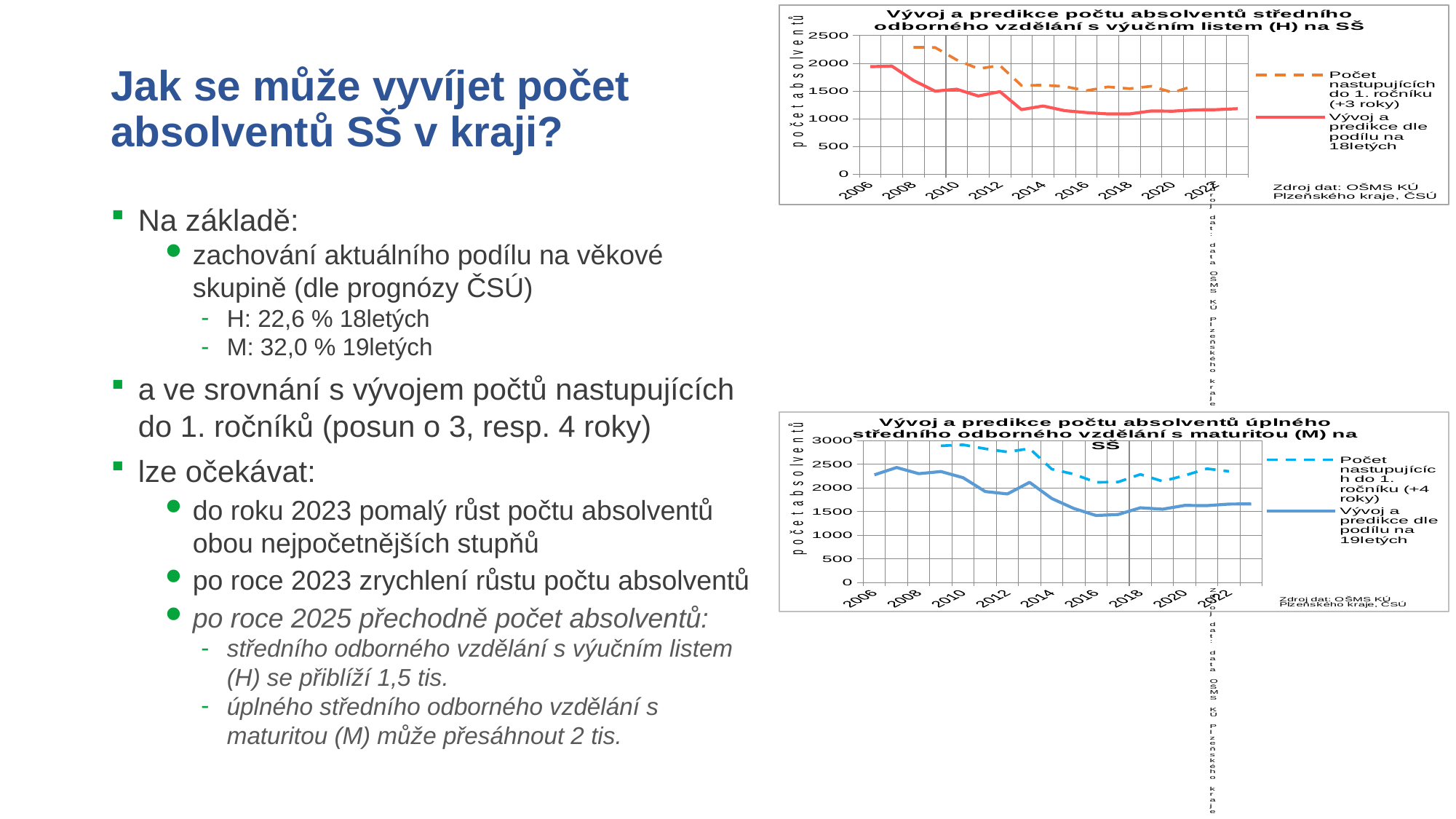
What kind of chart is the top chart, 'Vývoj a predikce počtu absolventů středního odborného vzdělání s výučním listem (H) na SŠ'? line chart In the top chart (H), is the dashed line 'Počet nastupujících do 1. ročníku (+3 roky)' in 2008 greater or less than 2000? greater In the bottom chart (M), is the dashed line 'Počet nastupujících do 1. ročníku (+4 roky)' in 2010 greater or less than 2500? greater What kind of chart is the bottom chart, 'Vývoj a predikce počtu absolventů úplného středního odborného vzdělání s maturitou (M) na SŠ'? line chart In the top chart (H), does the solid line 'Vývoj a predikce dle podílu na 18letých' overall rise or fall from 2006 to 2022? fall In the bottom chart (M), which series has the higher value in 2014: the dashed 'Počet nastupujících do 1. ročníku (+4 roky)' or the solid 'Vývoj a predikce dle podílu na 19letých'? Počet nastupujících do 1. ročníku (+4 roky) In the top chart (H), is the value of the solid line 'Vývoj a predikce dle podílu na 18letých' in 2006 greater or less than 1500? greater How many series does the legend of the bottom chart (M) list? 2 In the top chart (H), which series has the higher value in 2010: the dashed 'Počet nastupujících do 1. ročníku (+3 roky)' or the solid 'Vývoj a predikce dle podílu na 18letých'? Počet nastupujících do 1. ročníku (+3 roky) How many series does the legend of the top chart (H) list? 2